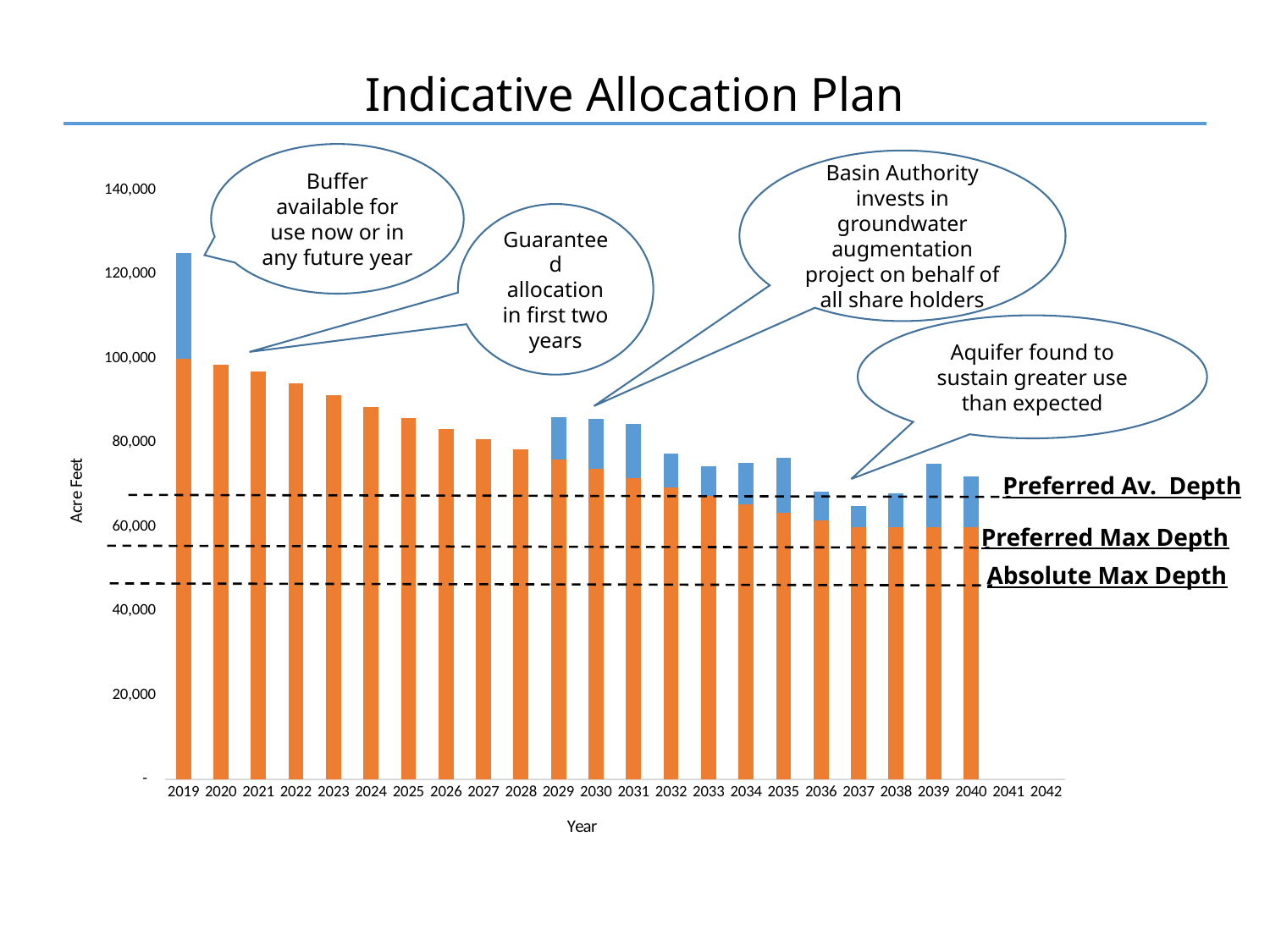
Is the value for 2024 greater or less than 80,000? greater Is the total value for 2037 greater or less than 60,000? greater How many years from 2019 onward have bars plotted on the chart? 22 Do the bar values generally rise or fall from 2019 to 2040? fall Which bar is taller, 2019 or 2040? 2019 What kind of chart is shown on the slide? Bar chart What is the title of the chart? Indicative Allocation Plan What is the label on the vertical axis of the chart? Acre Feet Is the total value for 2033 greater or less than 80,000? less Which bar is taller, 2021 or 2025? 2021 Which year has the tallest bar? 2019